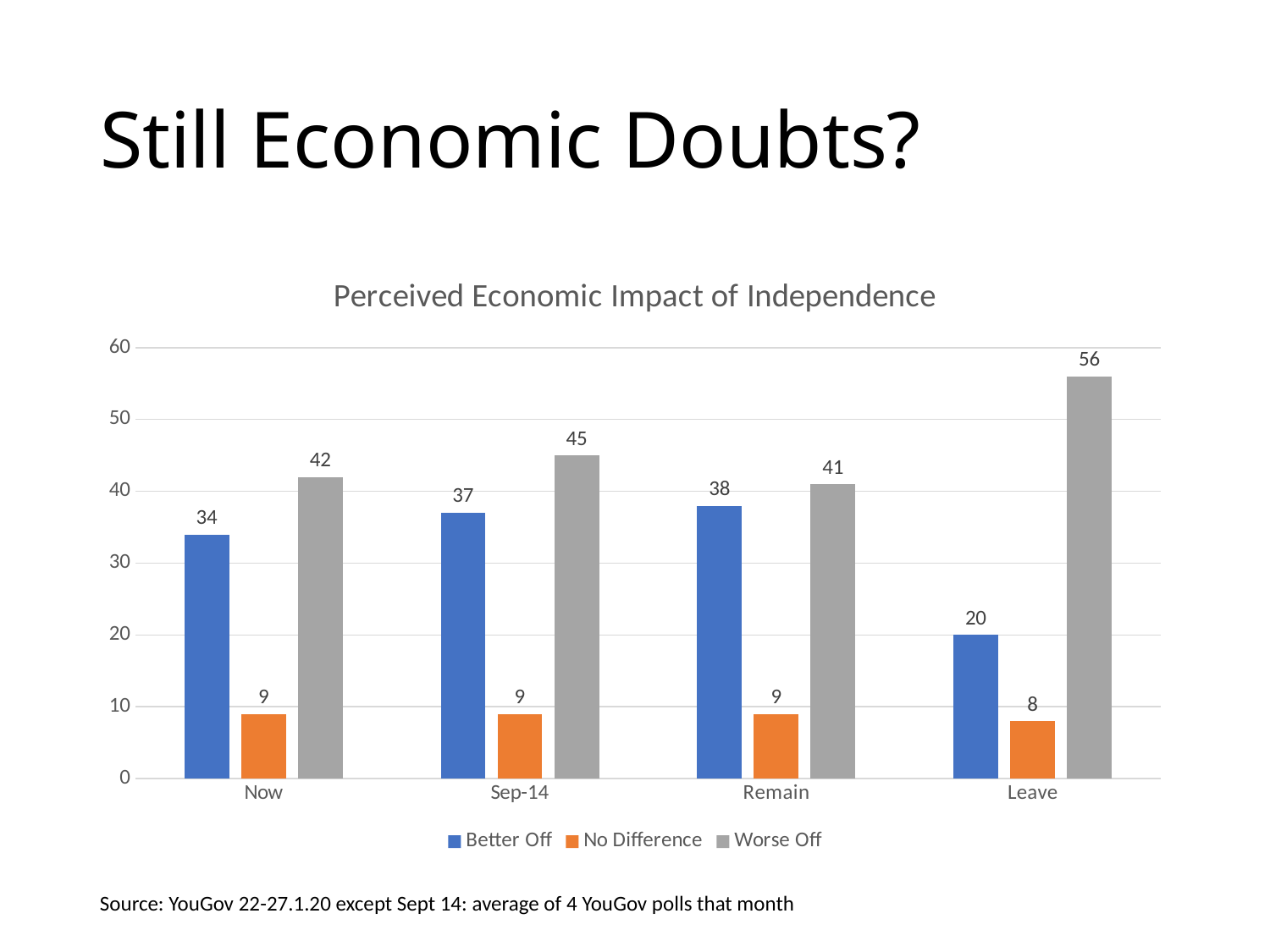
What is the title of the chart? Perceived Economic Impact of Independence Which category has the highest Worse Off value? Leave How many categories are shown on the x axis? 4 Which category has the lowest Better Off value? Leave Is the Worse Off value for Sep-14 greater or less than 40? greater What is the value for Worse Off in the Leave category? 56 What kind of chart is shown on the slide? Bar chart How many series does the legend list? 3 What is the value for Better Off in the Now category? 34 What is the difference between Worse Off and Better Off in the Leave category? 36 What is the value for No Difference in the Leave category? 8 Which is larger in the Remain category, Better Off or Worse Off? Worse Off